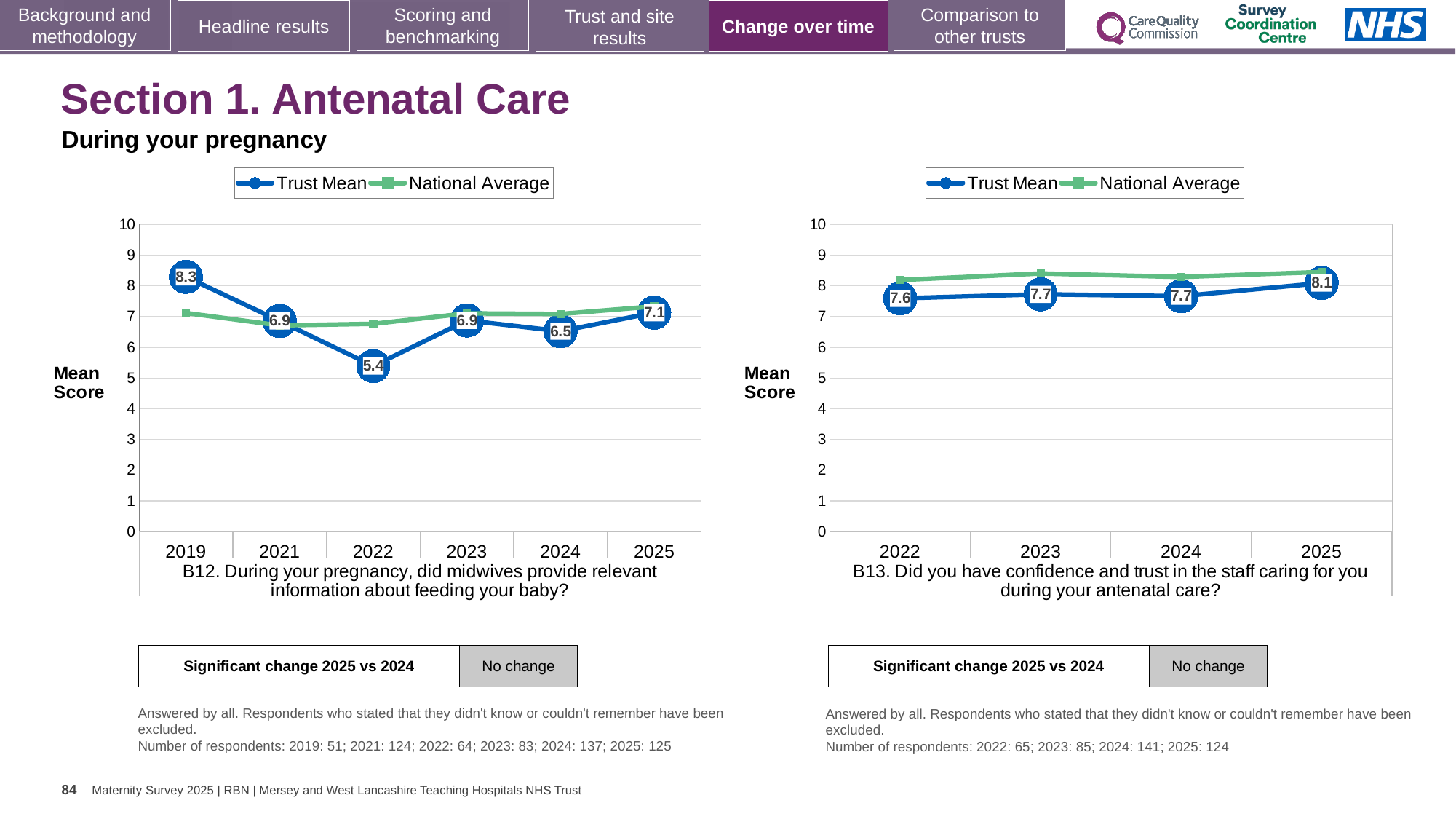
How many years are shown on the x axis of the B13 chart? 4 In the B13 chart, is the National Average value for 2023 greater or less than 8? greater In the B12 chart, which year has the lowest Trust Mean score? 2022 In the B12 chart, which year has the highest Trust Mean score? 2019 How many series does the legend of the B12 chart list? 2 In the B13 chart, what is the Trust Mean score for 2025? 8.1 In the B13 chart, which year has the highest Trust Mean score? 2025 In the B12 chart, what is the difference between the Trust Mean scores for 2019 and 2022? 2.9 In the B12 chart, is the Trust Mean score higher in 2024 or in 2025? 2025 In the B13 chart, what is the difference between the Trust Mean scores for 2025 and 2022? 0.5 In the B12 chart, what is the Trust Mean score for 2019? 8.3 In the B12 chart, what is the Trust Mean score for 2022? 5.4